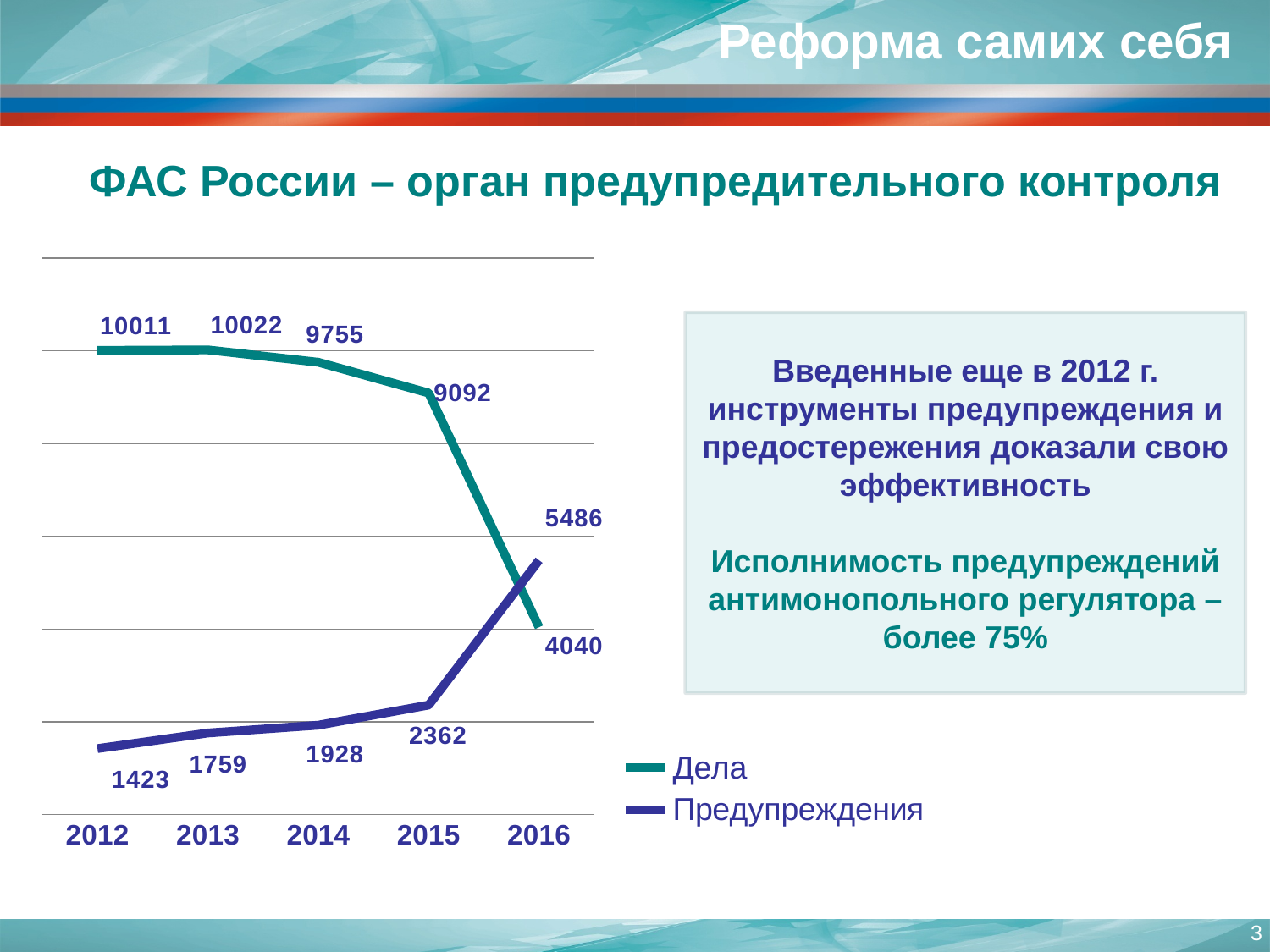
In which year is the value for Дела highest? 2013 What is the value for Дела in 2016? 4040 In which year is the value for Предупреждения lowest? 2012 How many series does the chart legend list? 2 Which is larger in 2016, Дела or Предупреждения? Предупреждения What is the difference between the Дела values for 2015 and 2016? 5052 What is the value for Дела in 2012? 10011 How many years are shown on the x axis? 5 What is the value for Предупреждения in 2016? 5486 Does the Предупреждения series rise or fall from 2012 to 2016? rise What type of chart is shown on the slide? line chart What is the value for Предупреждения in 2014? 1928